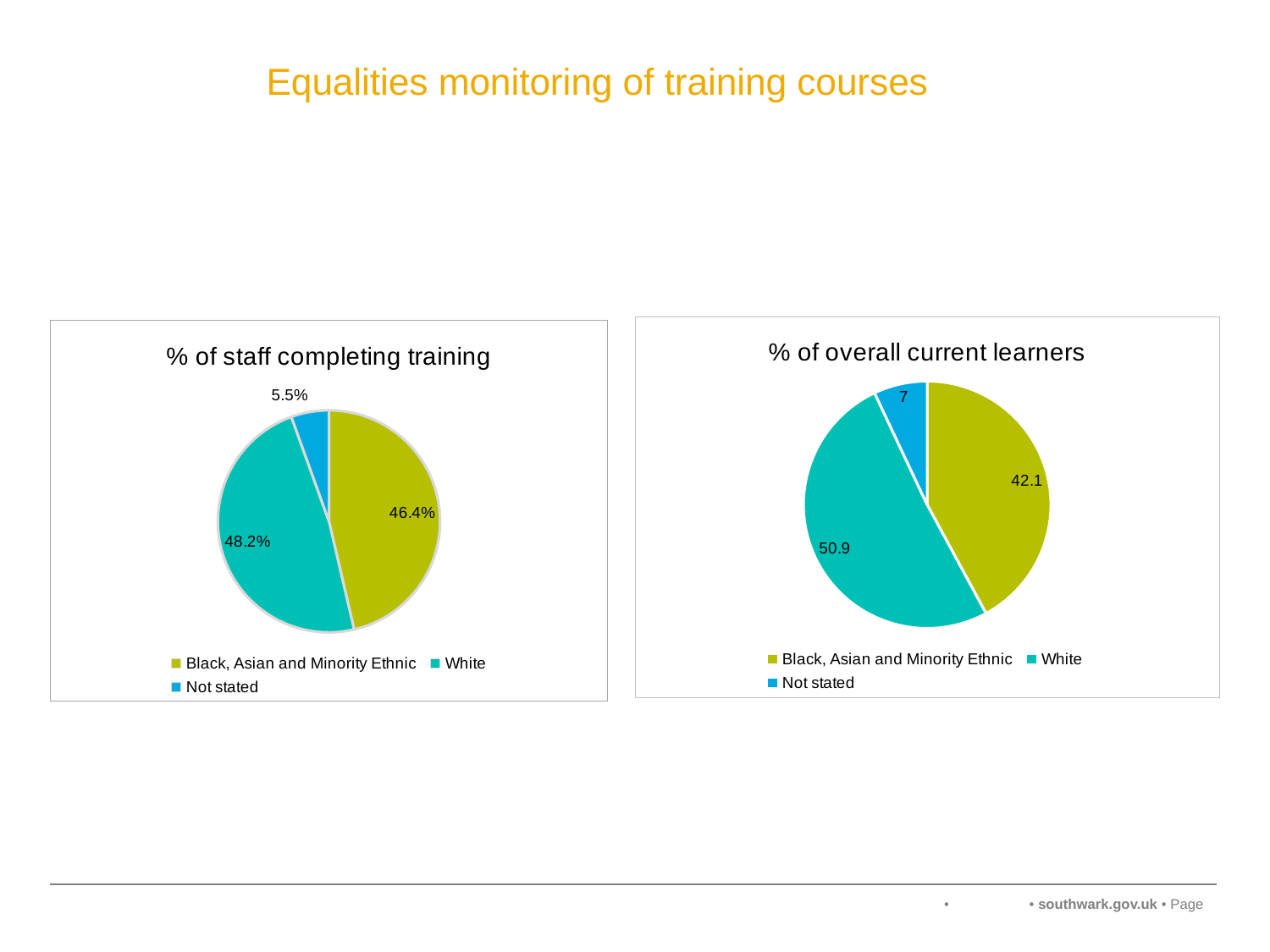
In the '% of staff completing training' chart, what is the value for Not stated? 5.5% What is the title of the chart on the left of the slide? % of staff completing training How many categories does the '% of staff completing training' chart show? 3 In the '% of overall current learners' chart, what is the value for Black, Asian and Minority Ethnic? 42.1 In the '% of staff completing training' chart, which category has the smallest slice? Not stated In the '% of overall current learners' chart, what is the difference between the White and Black, Asian and Minority Ethnic values? 8.8 In the '% of overall current learners' chart, which is larger: the value for White or the value for Black, Asian and Minority Ethnic? White In the '% of staff completing training' chart, what is the difference between the White and Black, Asian and Minority Ethnic values? 1.8% In the '% of overall current learners' chart, what is the value for Not stated? 7 In the '% of overall current learners' chart, which category has the largest slice? White In the '% of staff completing training' chart, what is the value for White? 48.2% What kind of chart is the '% of overall current learners' chart? Pie chart